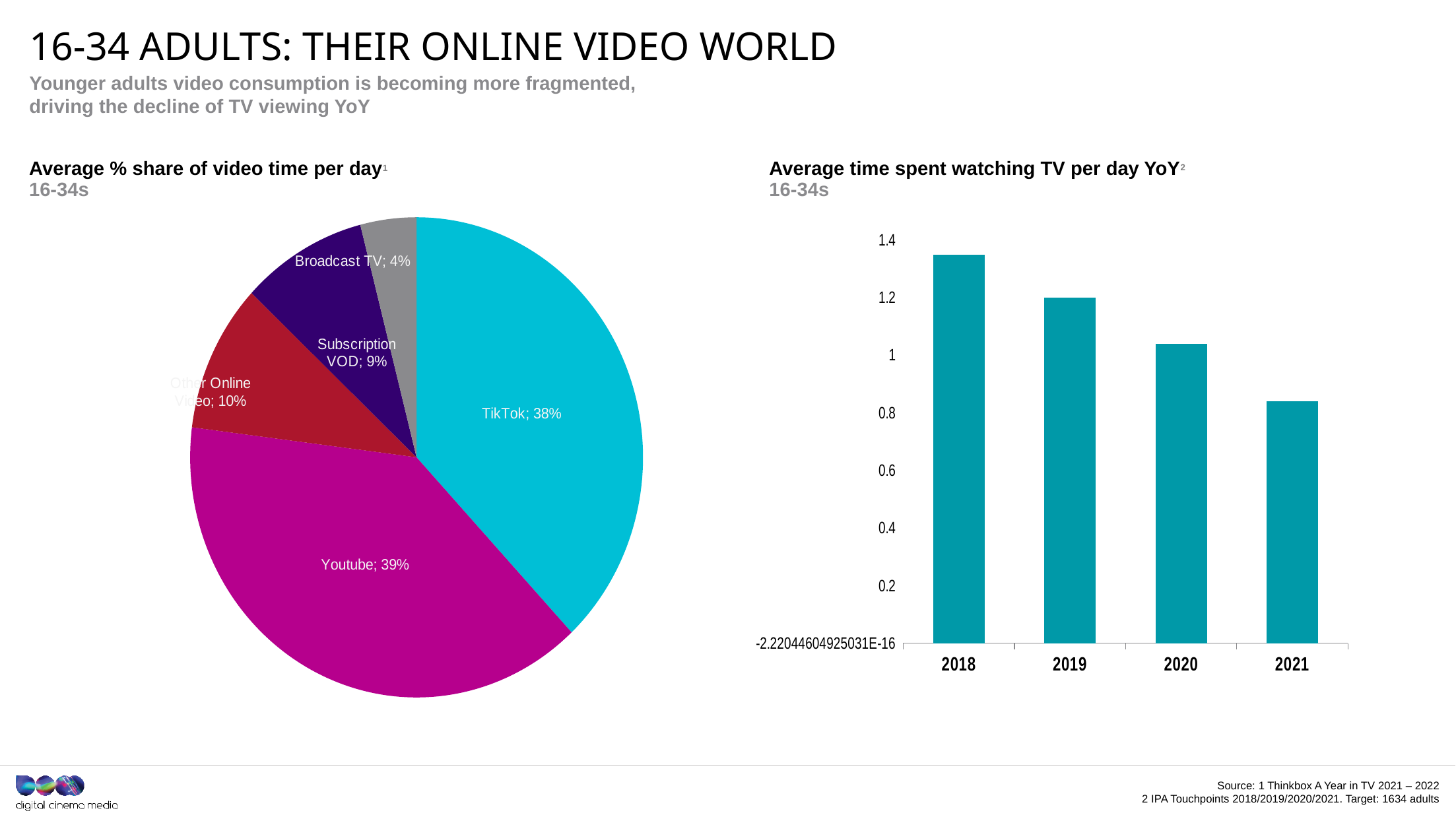
In the pie chart 'Average % share of video time per day', which category has the smallest share? Broadcast TV In the bar chart 'Average time spent watching TV per day YoY', is the value for 2018 greater or less than 1.2? greater How many slices does the pie chart 'Average % share of video time per day' have? 5 In the pie chart 'Average % share of video time per day', what share does Subscription VOD have? 9% In the bar chart 'Average time spent watching TV per day YoY', which year has the lowest value? 2021 In the pie chart 'Average % share of video time per day', which is larger: the share for Other Online Video or the share for Subscription VOD? Other Online Video In the bar chart 'Average time spent watching TV per day YoY', which year has the highest value? 2018 What kind of chart is 'Average time spent watching TV per day YoY'? Bar chart In the bar chart 'Average time spent watching TV per day YoY', do the values rise or fall from 2018 to 2021? fall In the pie chart 'Average % share of video time per day', what is the difference between the Youtube share and the Broadcast TV share? 35% In the pie chart 'Average % share of video time per day', what share does TikTok have? 38% In the pie chart 'Average % share of video time per day', which category has the largest share? Youtube